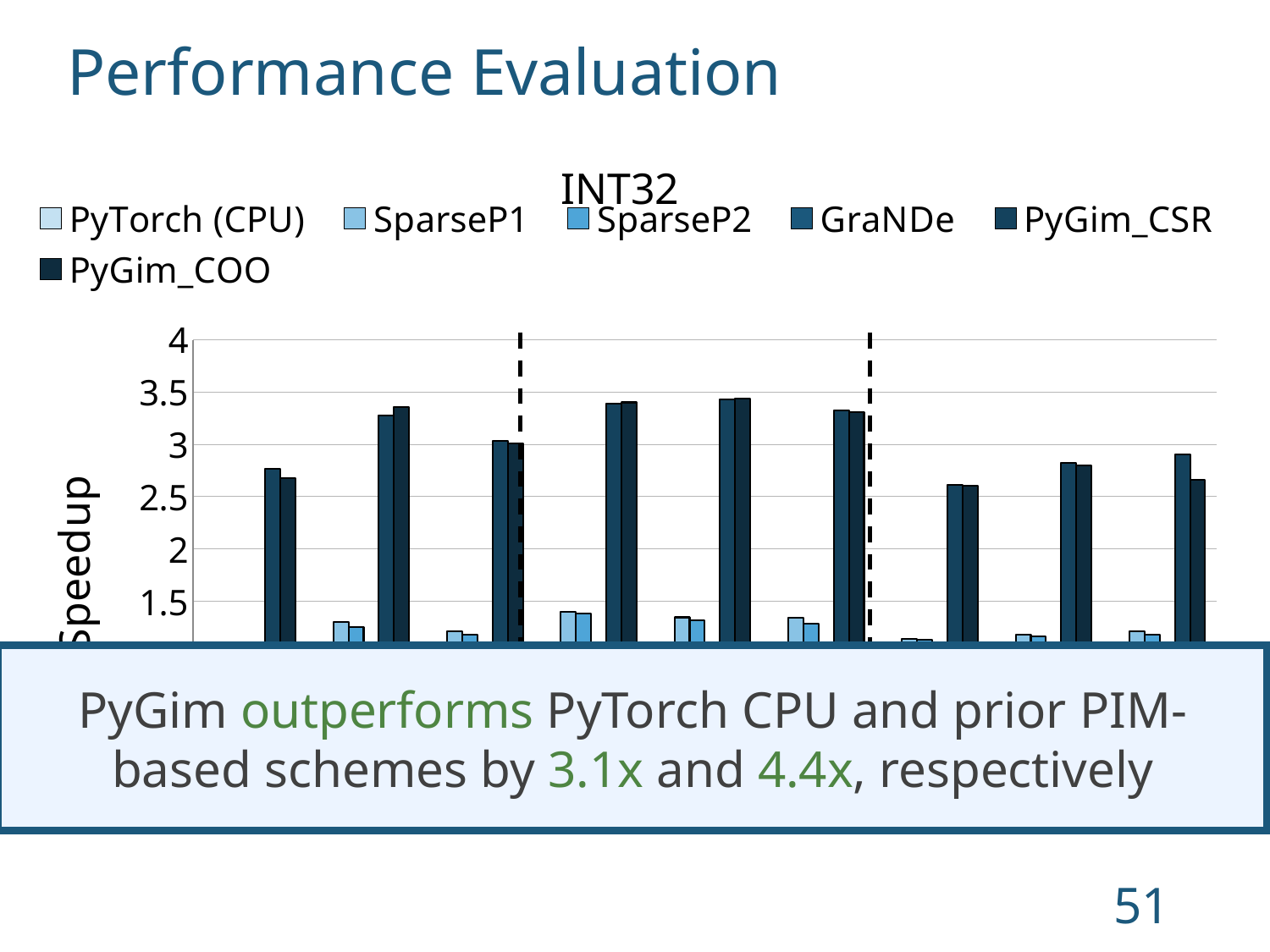
How many series does the legend of the INT32 chart list? 6 Is the tallest bar in the chart greater or less than 2.5? greater Is the tallest bar in the chart greater or less than 4? less What is the highest tick value shown on the Speedup axis? 4 What kind of chart is shown on the slide? bar chart Are the PyTorch (CPU) bars greater or less than 2 on the Speedup axis? less What is the title of the chart? INT32 What is the label on the vertical axis of the chart? Speedup